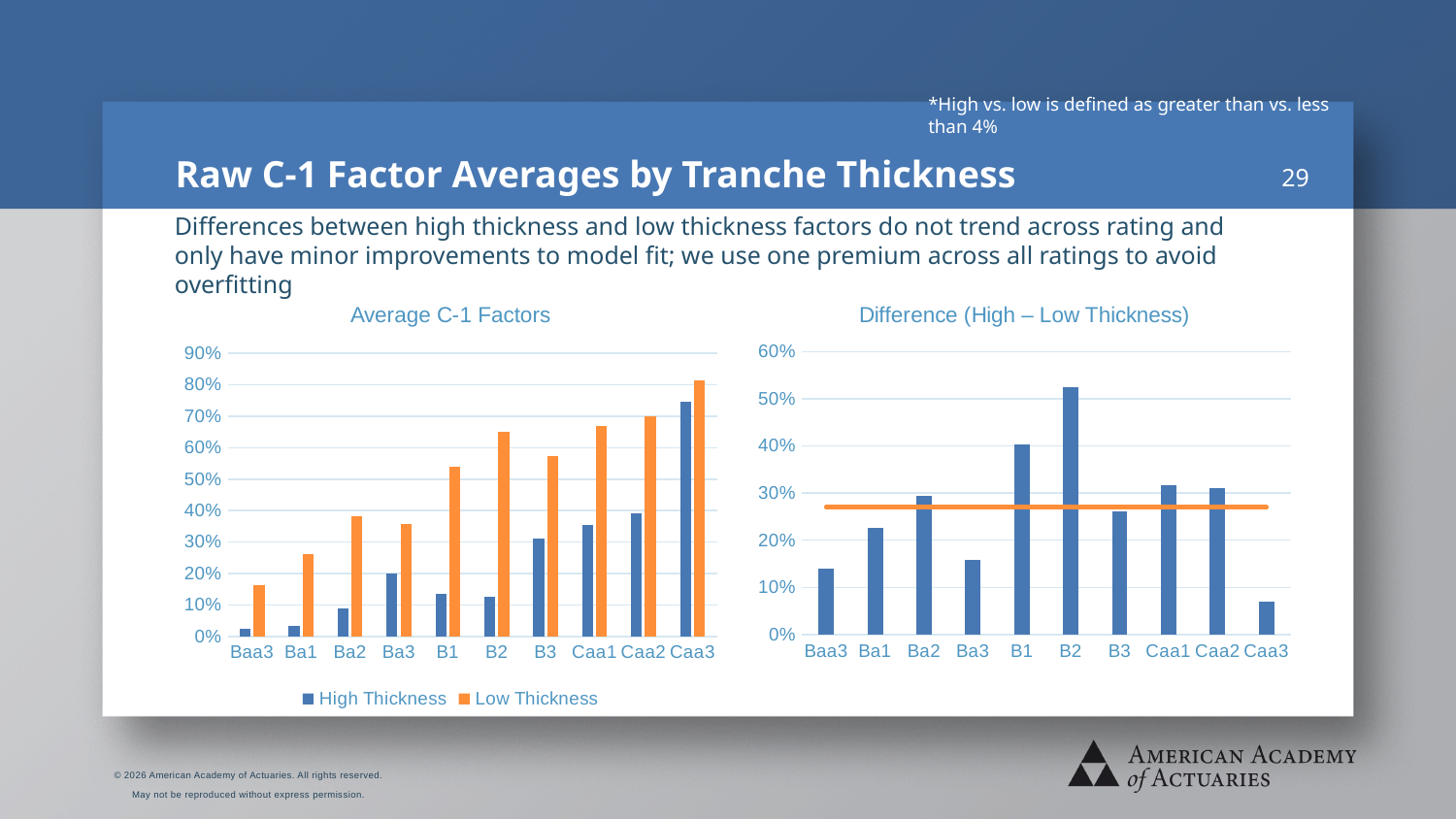
How many rating categories are shown on the x axis of the "Difference (High – Low Thickness)" chart? 10 What are the two legend entries of the "Average C-1 Factors" chart? High Thickness, Low Thickness In the "Difference (High – Low Thickness)" chart, which is larger: the value for Ba2 or the value for Ba3? Ba2 In the "Difference (High – Low Thickness)" chart, which rating has the lowest bar? Caa3 In the "Average C-1 Factors" chart, is the Low Thickness value for B2 greater or less than 60%? greater What kind of chart is the "Average C-1 Factors" chart on the left? bar chart In the "Difference (High – Low Thickness)" chart, which rating has the highest bar? B2 In the "Difference (High – Low Thickness)" chart, is the value for Caa3 greater or less than 10%? less In the "Average C-1 Factors" chart, which is larger for Ba2: High Thickness or Low Thickness? Low Thickness In the "Difference (High – Low Thickness)" chart, is the value for B1 greater or less than 30%? greater In the "Average C-1 Factors" chart, which rating has the highest Low Thickness value? Caa3 How many series does the legend of the "Average C-1 Factors" chart list? 2